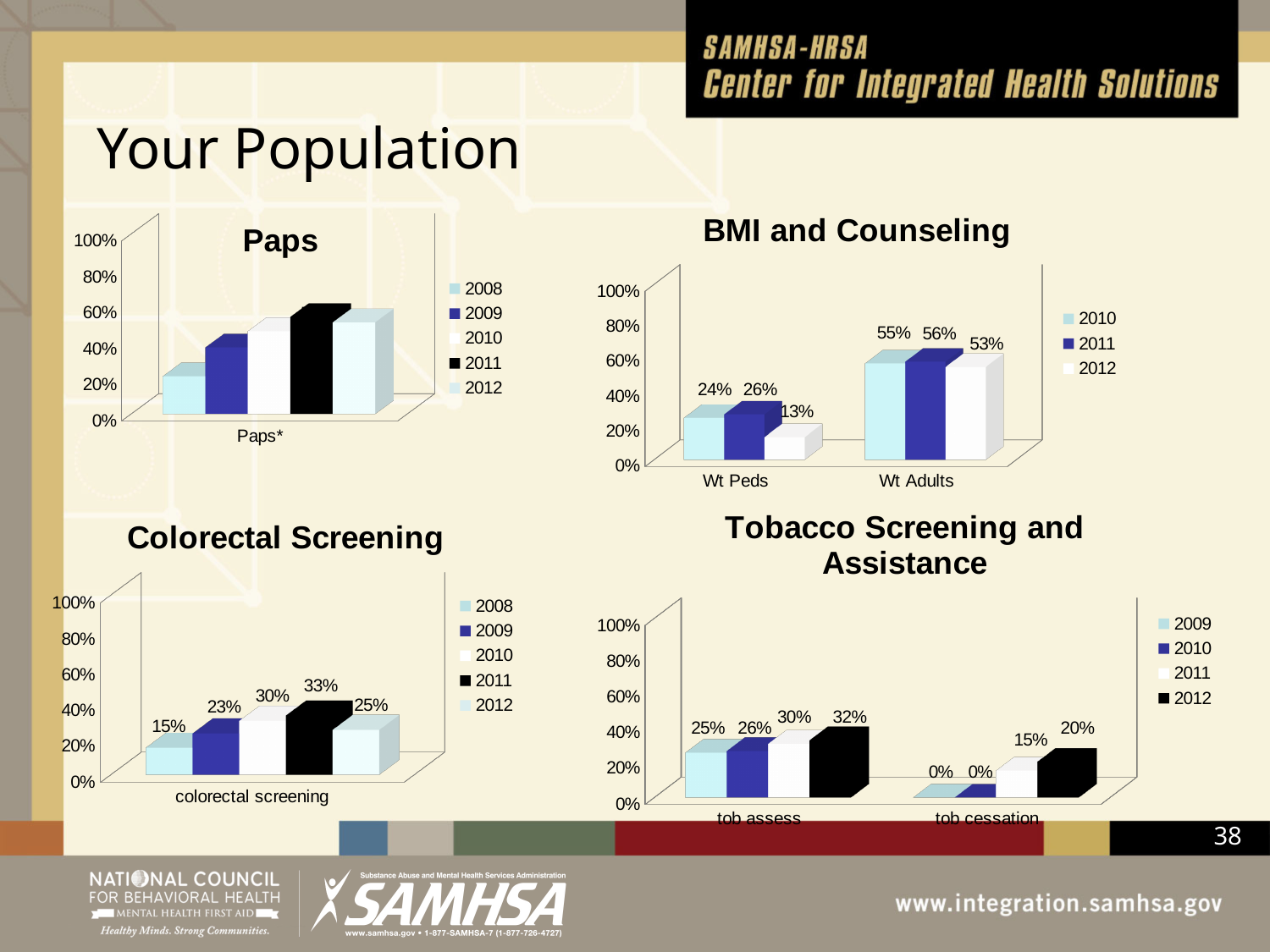
In the Paps chart, is the value for 2011 greater or less than 40%? greater In the Tobacco Screening and Assistance chart, which year has the highest value for tob assess? 2012 In the Colorectal Screening chart, which year has the lowest value? 2008 In the BMI and Counseling chart, what is the difference between the 2011 and 2012 values for Wt Adults? 3% How many series does the legend of the Tobacco Screening and Assistance chart list? 4 In the Colorectal Screening chart, what is the value for 2011? 33% What kind of chart is the Colorectal Screening chart? Bar chart In the BMI and Counseling chart, what is the 2012 value for Wt Peds? 13% In the Colorectal Screening chart, what is the difference between the 2011 and 2008 values? 18% In the Tobacco Screening and Assistance chart, what is the 2012 value for tob cessation? 20% In the BMI and Counseling chart, which is larger: the 2010 value for Wt Peds or the 2010 value for Wt Adults? Wt Adults In the Paps chart, is the value for 2008 greater or less than 40%? less